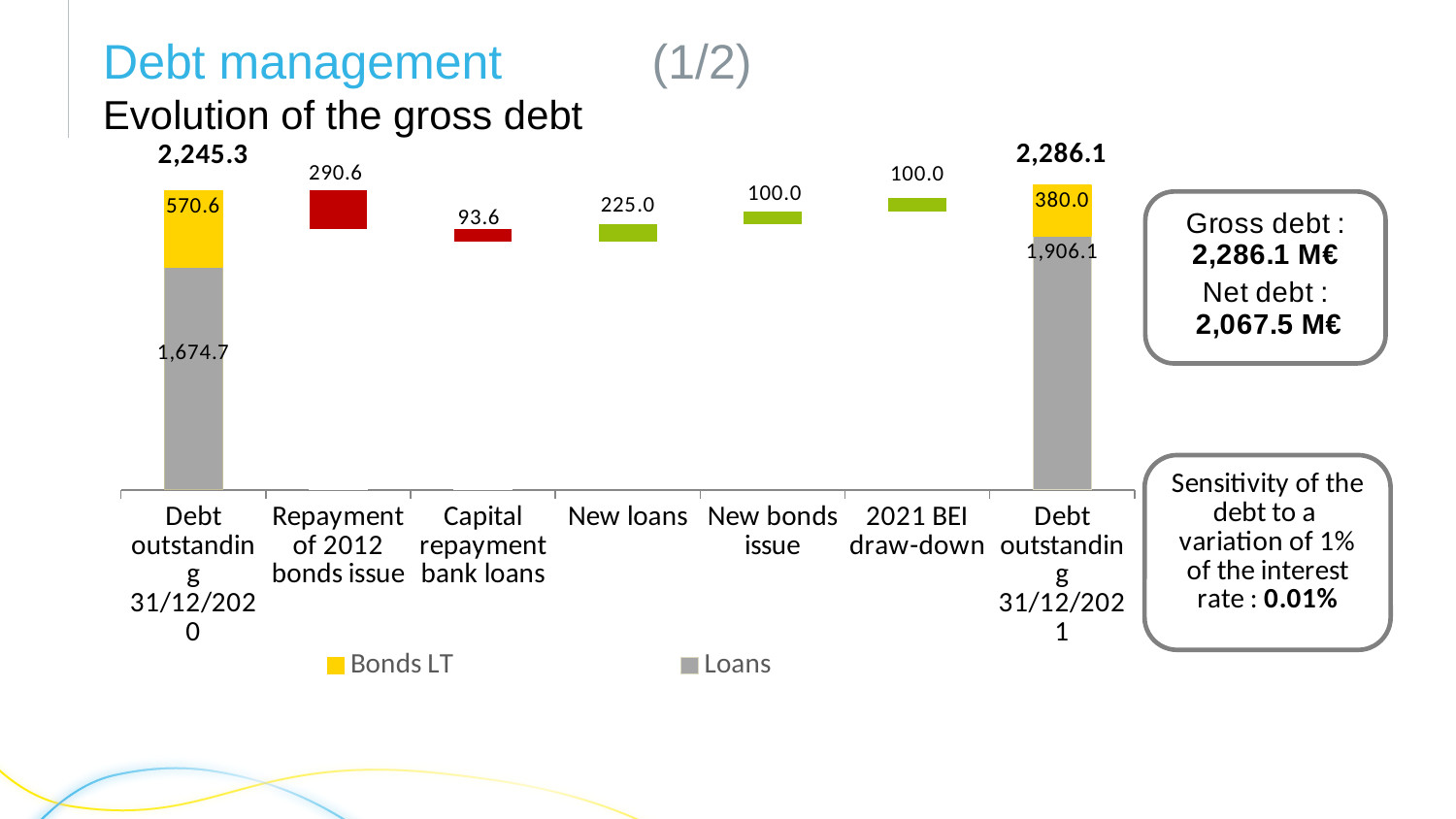
What value is shown for New loans? 225.0 What is the total debt outstanding at 31/12/2021 shown above the bar? 2,286.1 By how much did the Loans component increase from 31/12/2020 to 31/12/2021? 231.4 What is the Bonds LT value for Debt outstanding 31/12/2021? 380.0 What is the Loans value for Debt outstanding 31/12/2020? 1,674.7 What kind of chart is shown on the slide? Bar chart What value is shown for Repayment of 2012 bonds issue? 290.6 How many series does the legend list? 2 Which is larger: Repayment of 2012 bonds issue or Capital repayment bank loans? Repayment of 2012 bonds issue What is the total debt outstanding at 31/12/2020 shown above the bar? 2,245.3 What is the difference between the Bonds LT value at 31/12/2020 and at 31/12/2021? 190.6 How many categories are shown on the x axis? 7